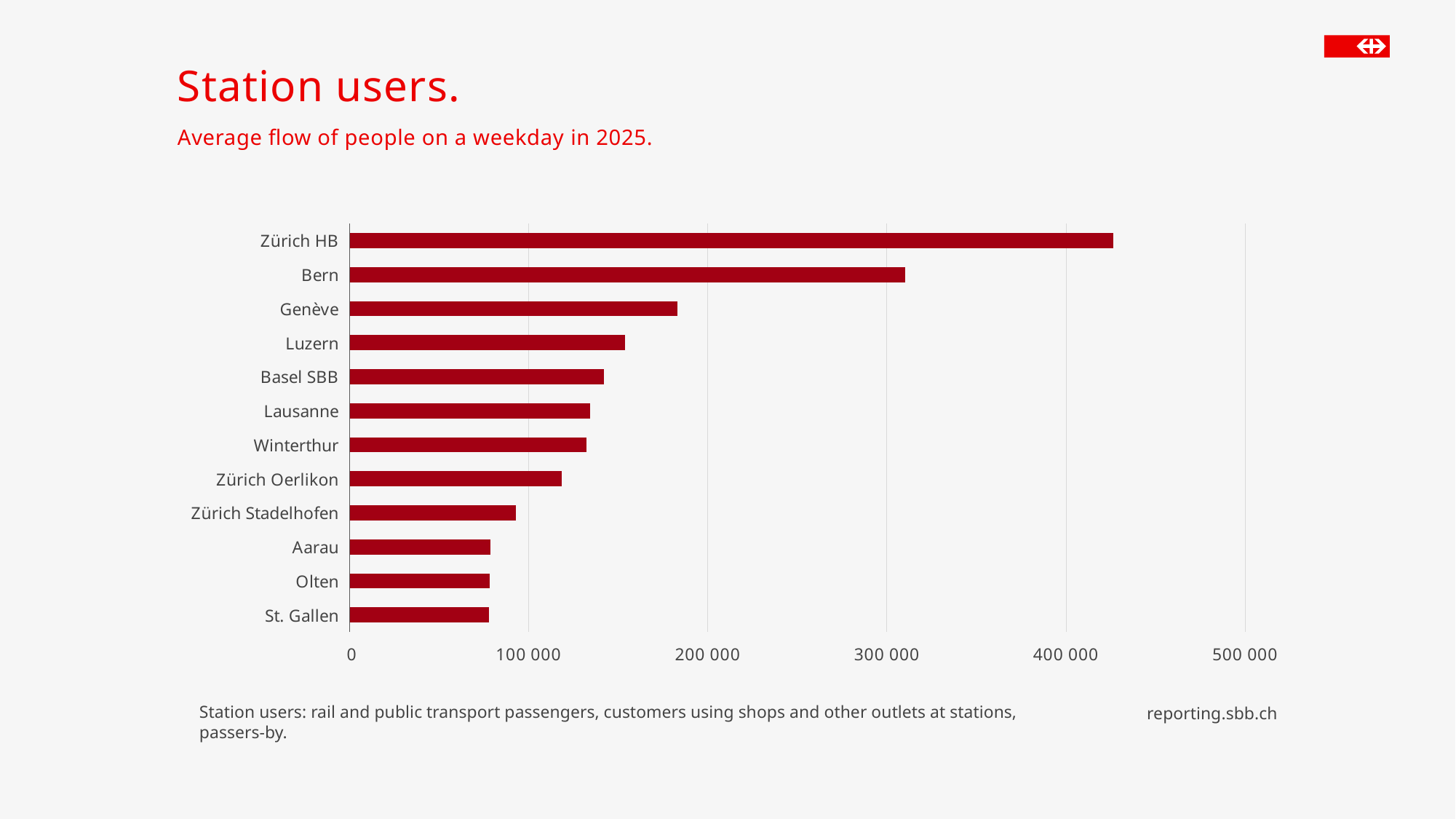
How many stations are listed in the chart? 12 What is the title of the slide? Station users. Is the value for Zürich Stadelhofen greater or less than 100 000? less Is the value for Bern greater or less than 300 000? greater Do the bar values increase or decrease from the top of the chart to the bottom? decrease Which station has the highest average flow of people? Zürich HB Is the value for Zürich HB greater or less than 400 000? greater Which has a larger value, Bern or Genève? Bern Which has a larger value, Luzern or Zürich Oerlikon? Luzern What kind of chart is shown on the slide? Bar chart